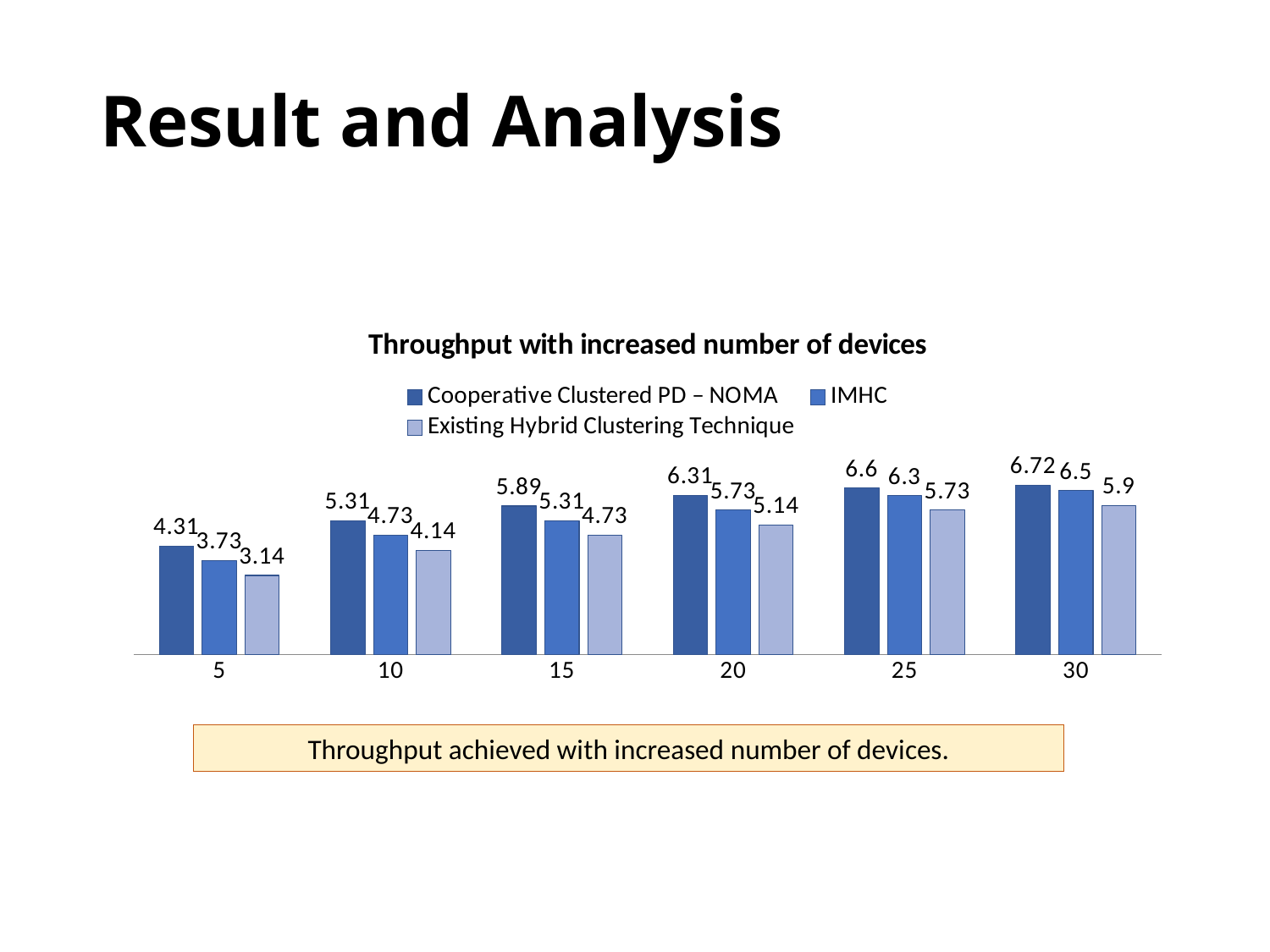
At which number of devices is the Existing Hybrid Clustering Technique throughput lowest? 5 How many series does the legend list? 3 What is the throughput for Cooperative Clustered PD – NOMA at 5 devices? 4.31 How many device-count categories are shown on the x axis? 6 Does the IMHC throughput rise or fall as the number of devices increases? Rises What is the difference between the Cooperative Clustered PD – NOMA and Existing Hybrid Clustering Technique throughput at 15 devices? 1.16 What is the title of the chart? Throughput with increased number of devices What kind of chart is shown on the slide? Bar chart What is the throughput for the Existing Hybrid Clustering Technique at 30 devices? 5.9 What is the throughput for IMHC at 20 devices? 5.73 At which number of devices is the Cooperative Clustered PD – NOMA throughput highest? 30 Which series has the higher throughput at 25 devices, IMHC or Existing Hybrid Clustering Technique? IMHC